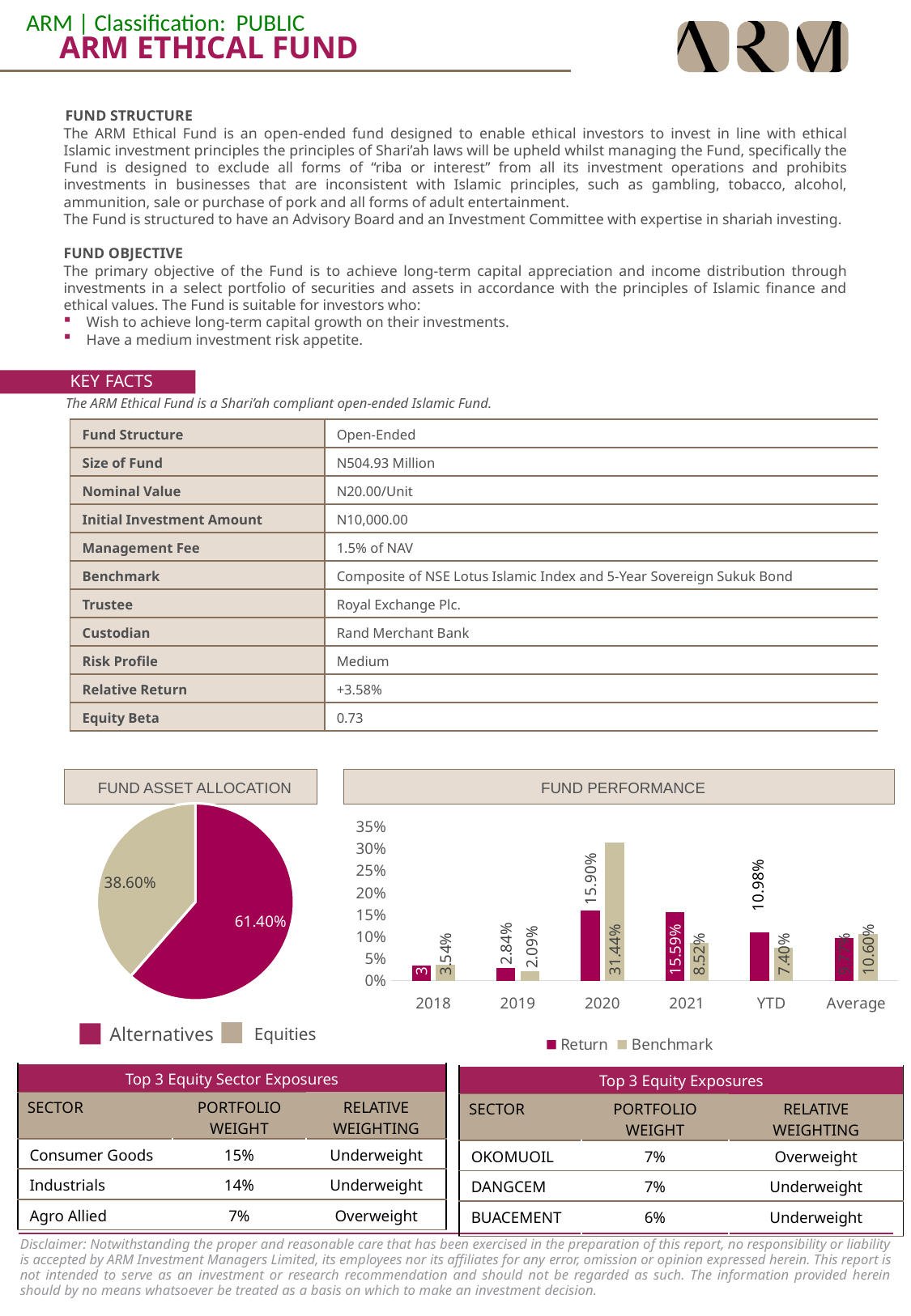
How many categories are shown on the x axis of the FUND PERFORMANCE chart? 6 In the FUND PERFORMANCE chart, what is the Return value for 2021? 15.59% In the FUND PERFORMANCE chart, what is the Benchmark value for 2020? 31.44% How many series does the legend of the FUND PERFORMANCE chart list? 2 In the FUND PERFORMANCE chart, what is the difference between the Return and the Benchmark for 2021? 7.07% In the FUND ASSET ALLOCATION chart, which slice is larger, Alternatives or Equities? Alternatives In the FUND PERFORMANCE chart, is the Benchmark value for 2020 greater or less than 30%? greater What kind of chart is the FUND PERFORMANCE chart? Bar chart What kind of chart is the FUND ASSET ALLOCATION chart? Pie chart In the FUND ASSET ALLOCATION chart, what share of the fund is in Equities? 38.60% In the FUND PERFORMANCE chart, which category has the highest Benchmark value? 2020 In the FUND ASSET ALLOCATION chart, what share of the fund is in Alternatives? 61.40%